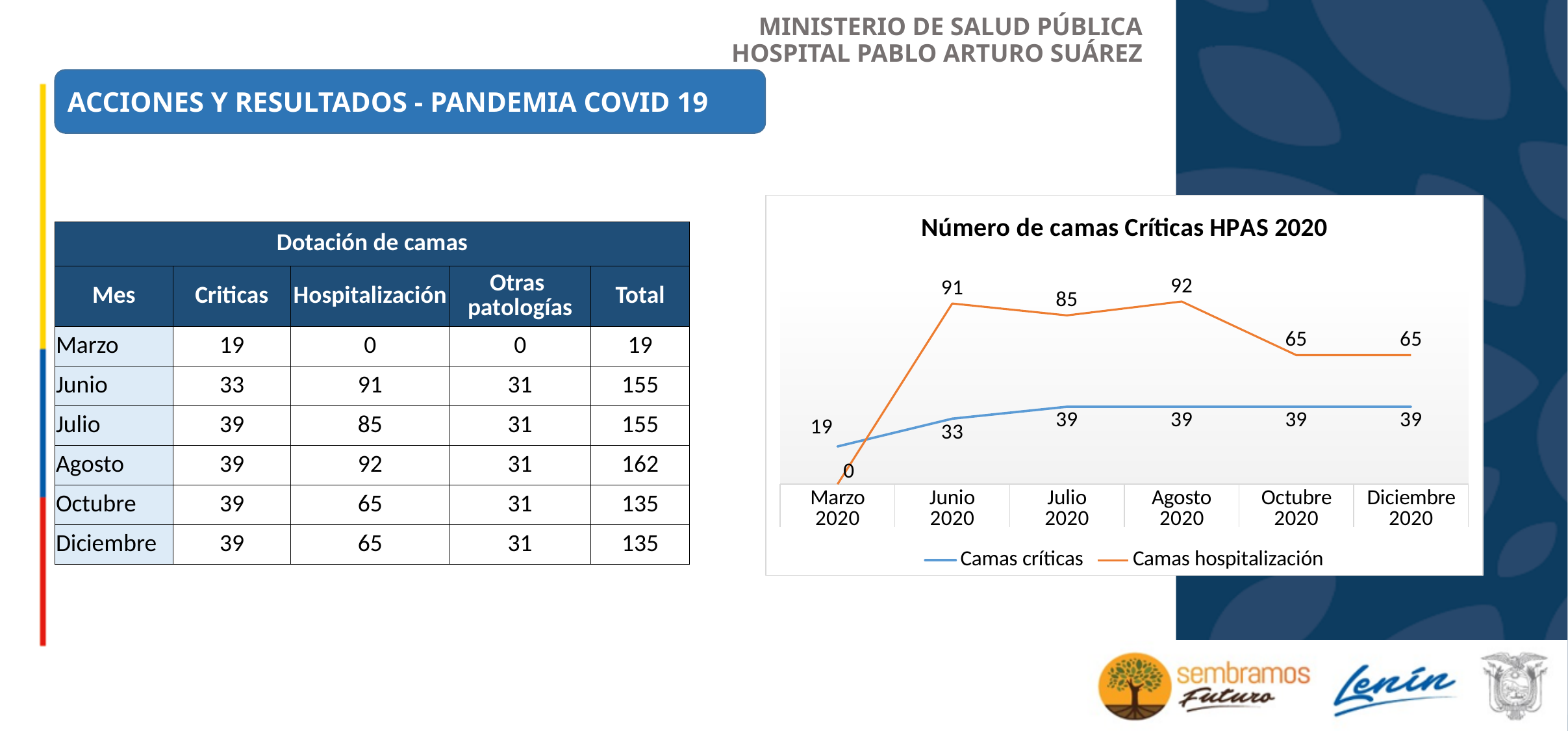
What is the value for Camas hospitalización in Agosto 2020? 92 What is the value for Camas críticas in Junio 2020? 33 How many series does the legend list? 2 Which is larger in Marzo 2020, Camas críticas or Camas hospitalización? Camas críticas What is the difference between Camas hospitalización and Camas críticas in Junio 2020? 58 What is the value for Camas hospitalización in Marzo 2020? 0 In which month is Camas críticas lowest? Marzo 2020 Does Camas hospitalización rise or fall from Agosto 2020 to Octubre 2020? Fall How many months are plotted on the x axis? 6 What is the title of the chart? Número de camas Críticas HPAS 2020 In which month is Camas hospitalización highest? Agosto 2020 What kind of chart is shown? Line chart